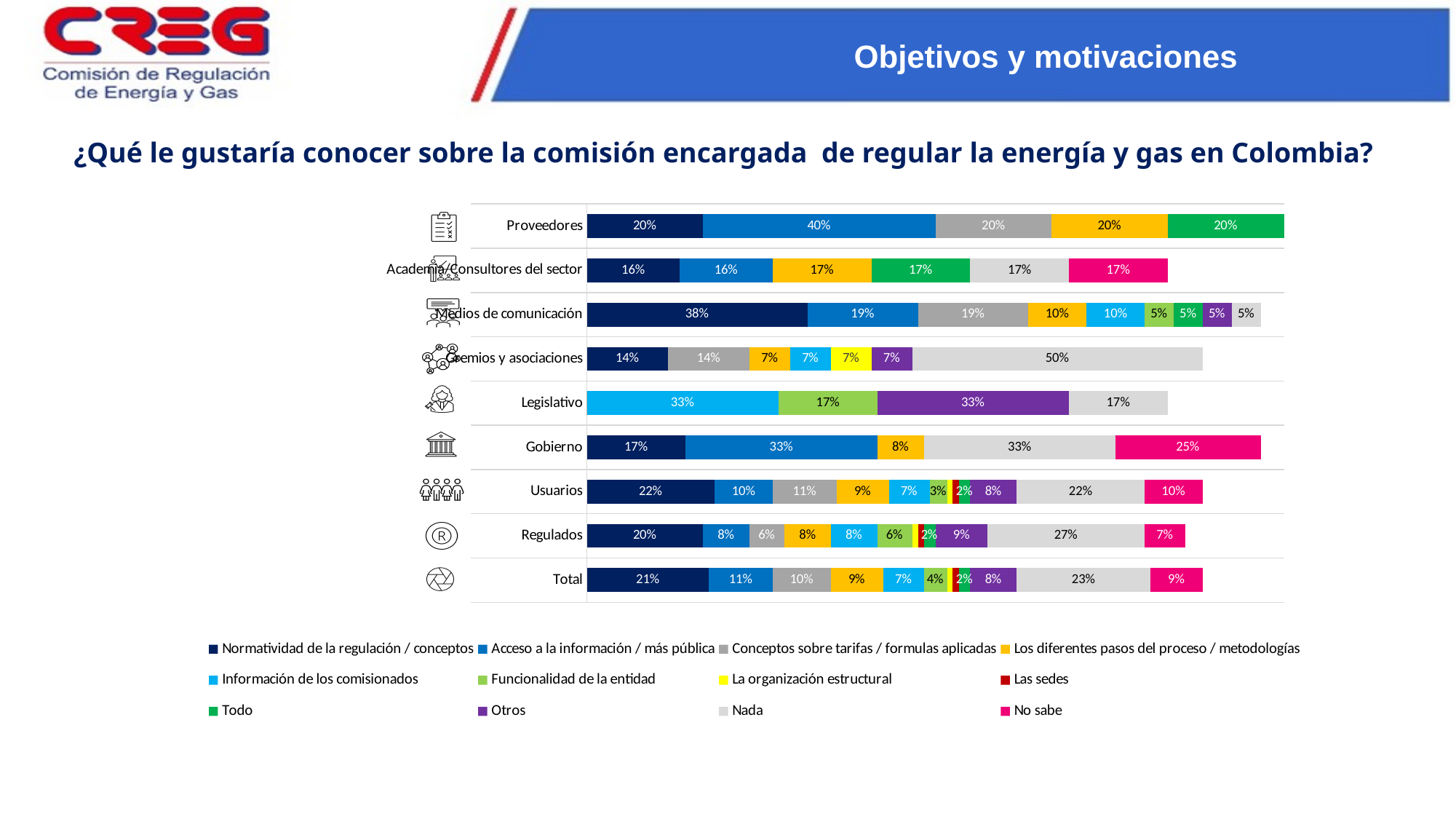
What is the 'Nada' value for Gremios y asociaciones? 50% What percentage of Proveedores chose 'Acceso a la información / más pública'? 40% What percentage of Gobierno respondents answered 'No sabe'? 25% What is the difference between the 'Normatividad de la regulación / conceptos' values for Medios de comunicación and Gremios y asociaciones? 24 percentage points What is the 'Nada' value in the Total bar? 23% Which category has the largest 'Normatividad de la regulación / conceptos' segment? Medios de comunicación How many series does the legend list? 12 How many categories (bars) are shown in the chart? 9 Which category has the largest 'Nada' segment? Gremios y asociaciones What kind of chart is shown on the slide? Stacked bar chart Which is larger: the 'No sabe' value for Gobierno or for Usuarios? Gobierno What is the 'Normatividad de la regulación / conceptos' value for Medios de comunicación? 38%